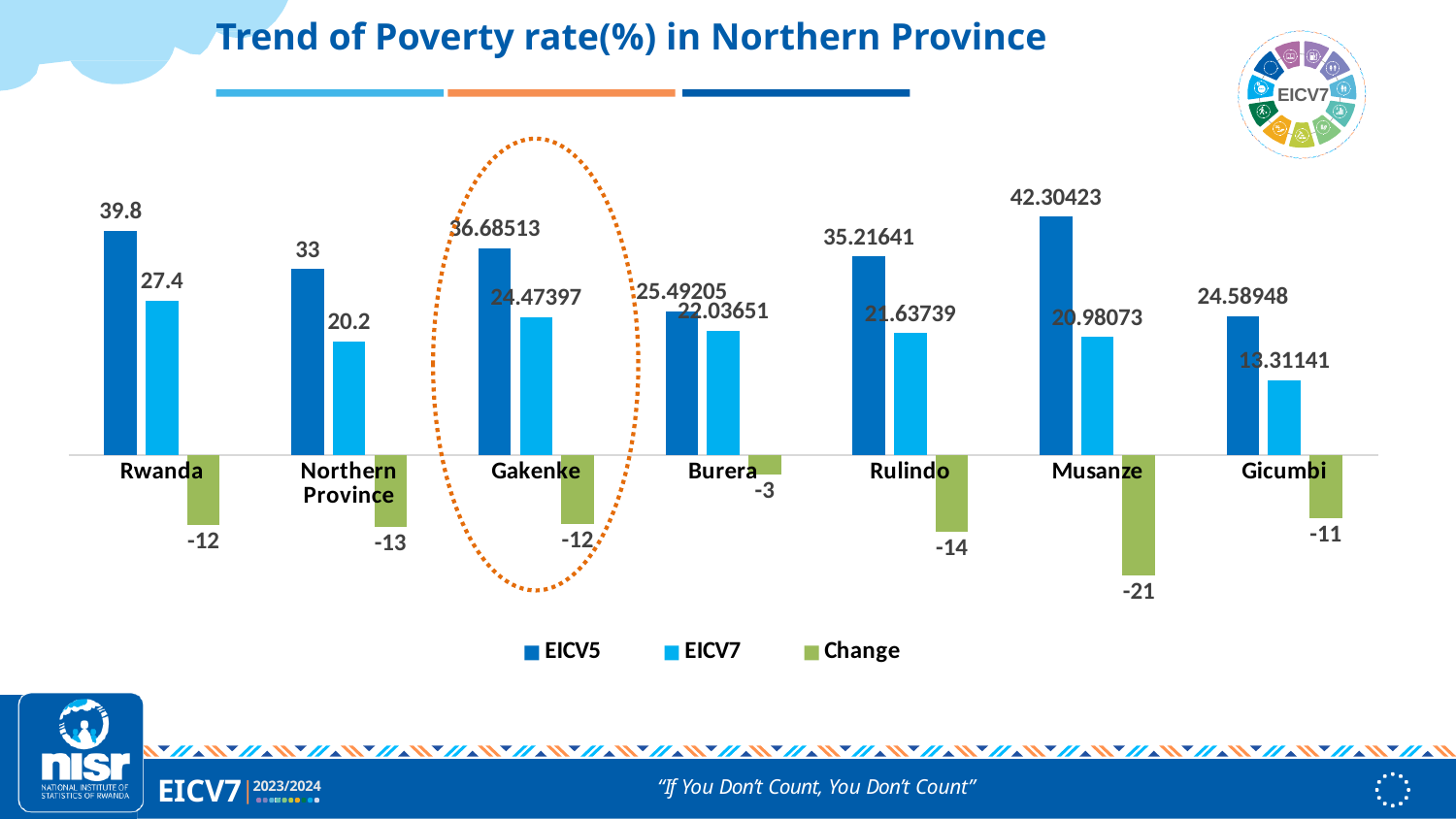
What is the EICV7 poverty rate for Northern Province? 20.2 How many series does the legend list? 3 Which category has the highest EICV5 poverty rate? Musanze What kind of chart is shown on the slide? Bar chart How many categories are shown on the x axis? 7 Which has a higher EICV7 poverty rate, Gakenke or Burera? Gakenke What is the difference between the EICV5 and EICV7 poverty rates for Rwanda? 12.4 What is the Change value for Burera? -3 Which category has the lowest EICV7 poverty rate? Gicumbi What is the EICV7 poverty rate for Musanze? 20.98073 What is the EICV5 poverty rate for Rwanda? 39.8 Which category has the largest negative Change value? Musanze